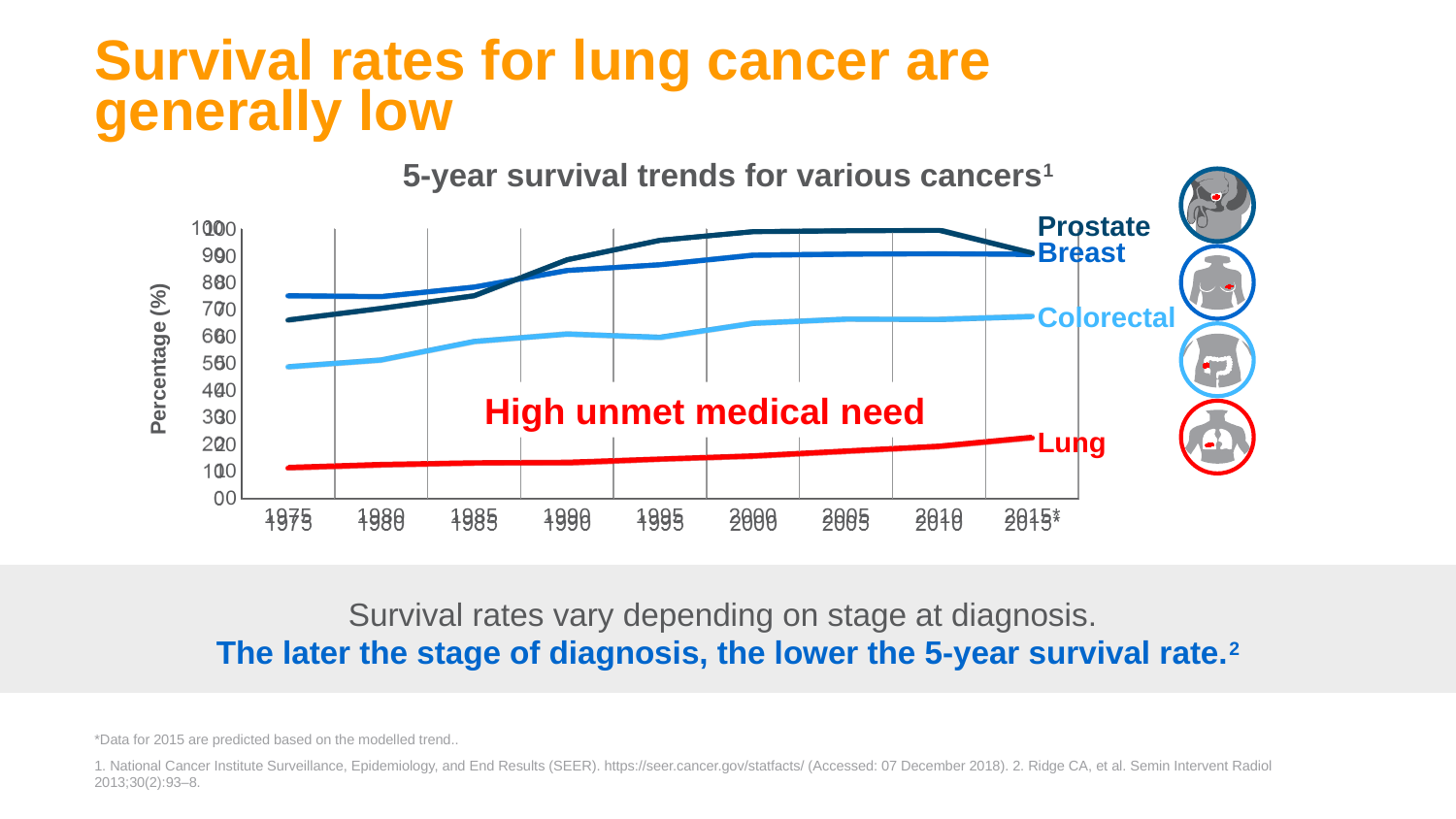
How many year labels are shown on the x axis of the chart? 9 Is the 5-year survival rate for colorectal cancer in 2015* greater or less than 60? greater What is the title of the chart? 5-year survival trends for various cancers Which cancer type had the highest 5-year survival rate in 1975? Breast How many cancer types (series) are plotted in the chart? 4 Is the 5-year survival rate for lung cancer in 1975 greater or less than 20? less Which cancer type has the lowest 5-year survival rate across the whole period? Lung Which has a higher 5-year survival rate in 2015*: colorectal cancer or lung cancer? Colorectal What kind of chart is shown on the slide? Line chart Does the 5-year survival rate for prostate cancer rise or fall from 1975 to 2010? rise